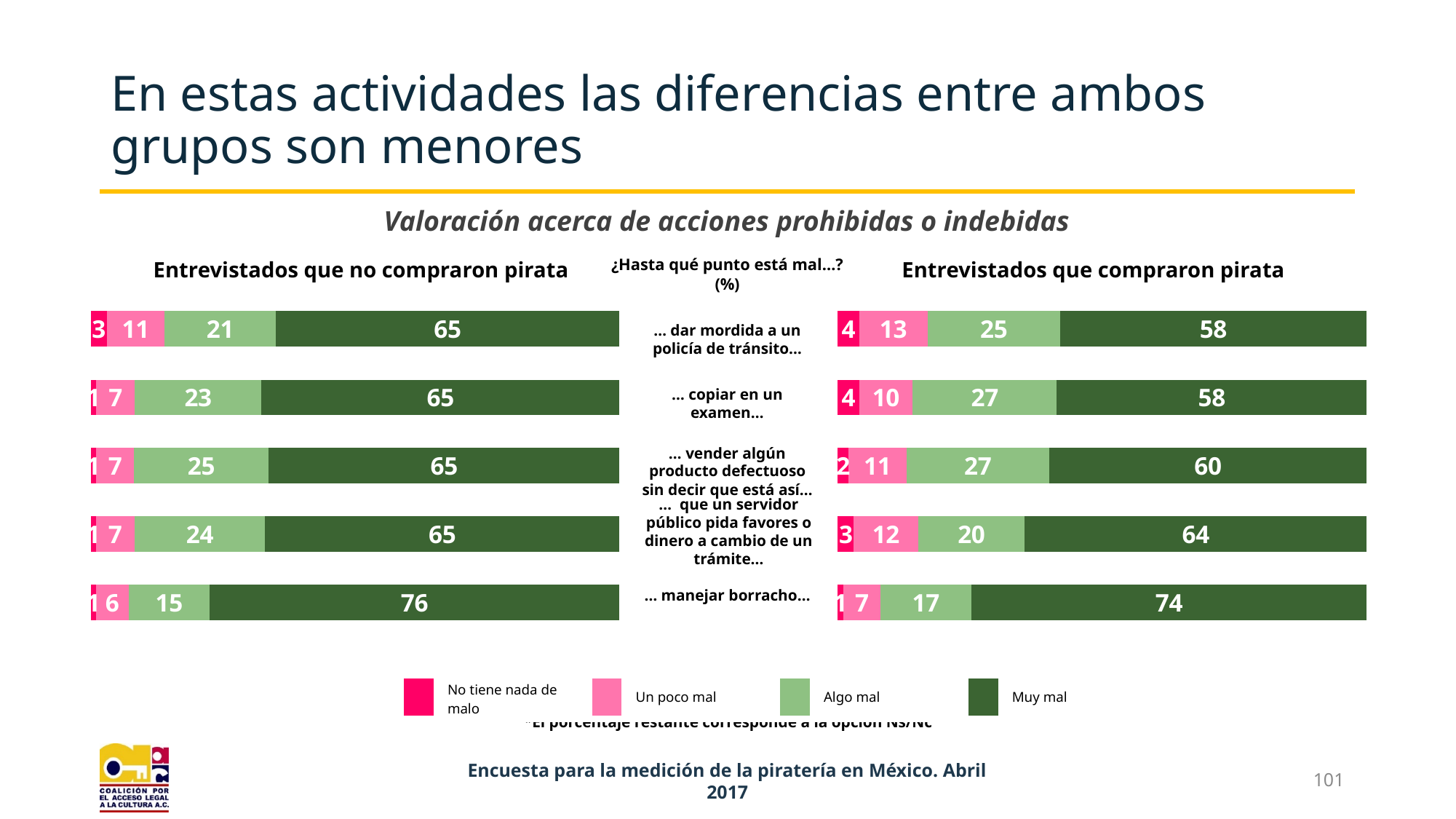
How many activities are shown in the chart 'Entrevistados que compraron pirata'? 5 Which legend entry is shown in dark green? Muy mal In the chart 'Entrevistados que compraron pirata', what is the 'Algo mal' value for '... copiar en un examen...'? 27 In the chart 'Entrevistados que no compraron pirata', which activity has the highest 'Muy mal' value? ... manejar borracho... In the chart 'Entrevistados que no compraron pirata', what is the 'Muy mal' value for '... manejar borracho...'? 76 Which is larger: the 'Algo mal' value for '... vender algún producto defectuoso sin decir que está así...' in the 'no compraron pirata' chart or in the 'compraron pirata' chart? compraron pirata (27) In the chart 'Entrevistados que compraron pirata', what is the total of the four labelled segments for '... que un servidor público pida favores o dinero a cambio de un trámite...'? 99 In the chart 'Entrevistados que compraron pirata', what is the 'Un poco mal' value for '... dar mordida a un policía de tránsito...'? 13 What is the difference between the 'Muy mal' value for '... manejar borracho...' in the 'no compraron pirata' chart and in the 'compraron pirata' chart? 2 How many series does the legend list? 4 What kind of chart is used for 'Entrevistados que no compraron pirata'? Stacked horizontal bar chart In the chart 'Entrevistados que compraron pirata', which activity has the lowest 'Muy mal' value? ... dar mordida a un policía de tránsito... and ... copiar en un examen... (both 58)